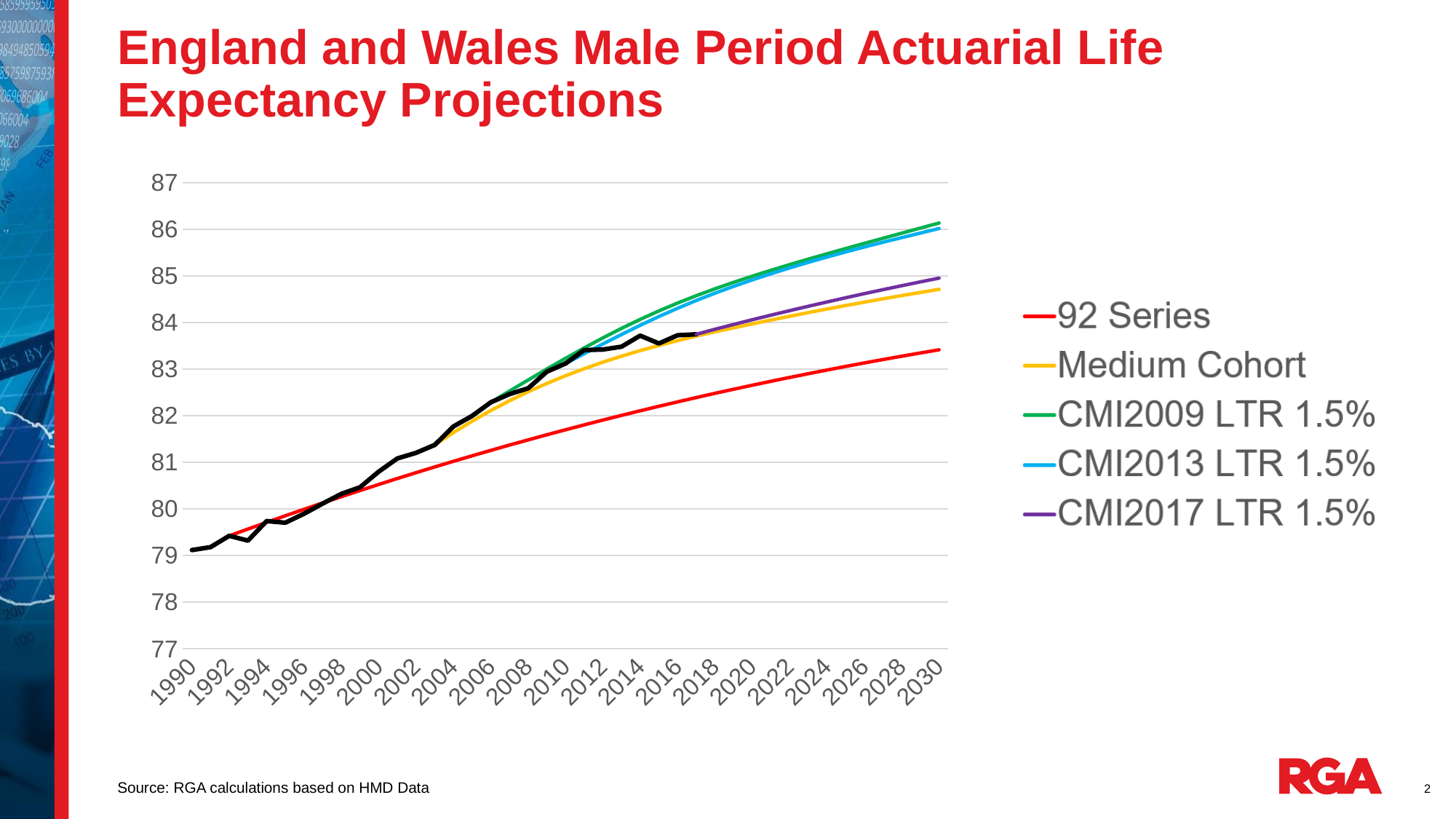
At 2030, which is higher: CMI2013 LTR 1.5% or 92 Series? CMI2013 LTR 1.5% Is the value of the 92 Series at 2030 greater or less than 83? greater Is the value of the 92 Series at 2030 greater or less than 84? less Is the value of Medium Cohort at 2030 greater or less than 85? less What kind of chart is shown on the slide? Line chart How many series does the legend list? 5 How many year labels are shown on the x axis? 21 Which colour is used for the 92 Series line? Red Does the 92 Series line rise or fall from 1990 to 2030? Rise What is the title of the slide's chart? England and Wales Male Period Actuarial Life Expectancy Projections Which legend series has the lowest value at 2030? 92 Series